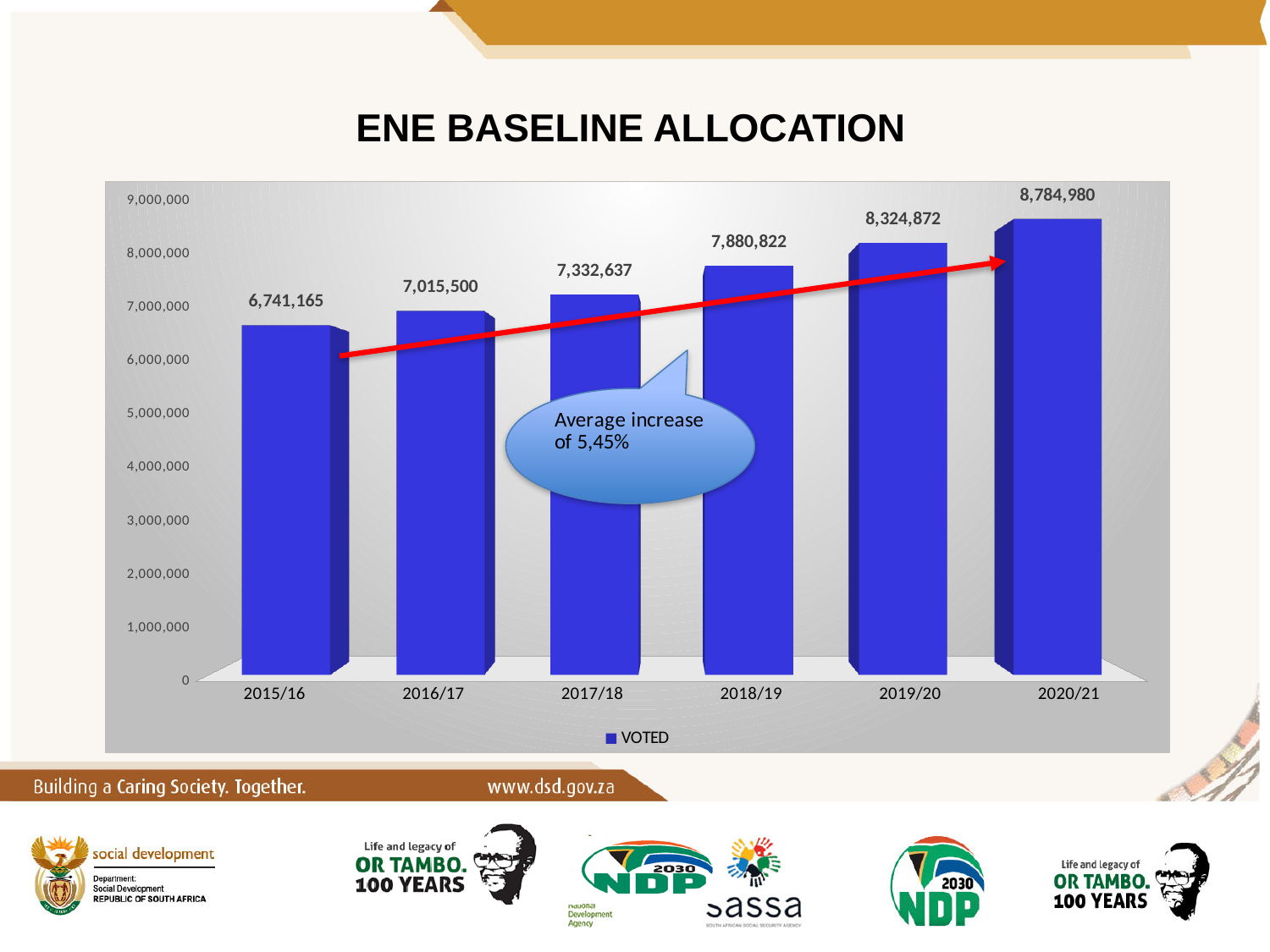
What is the difference between the 2020/21 and 2015/16 values? 2,043,815 Do the values rise or fall from 2015/16 to 2020/21? Rise Which year has the lowest VOTED allocation? 2015/16 What is the difference between the 2019/20 and 2018/19 values? 444,050 What is the VOTED value for 2020/21? 8,784,980 What is the VOTED value for 2015/16? 6,741,165 Which year has the highest VOTED allocation? 2020/21 Is the value for 2019/20 greater or less than 8,000,000? greater What kind of chart is shown on the slide? Bar chart How many years are shown on the x axis? 6 What is the VOTED value for 2018/19? 7,880,822 Which is larger, the value for 2017/18 or the value for 2016/17? 2017/18